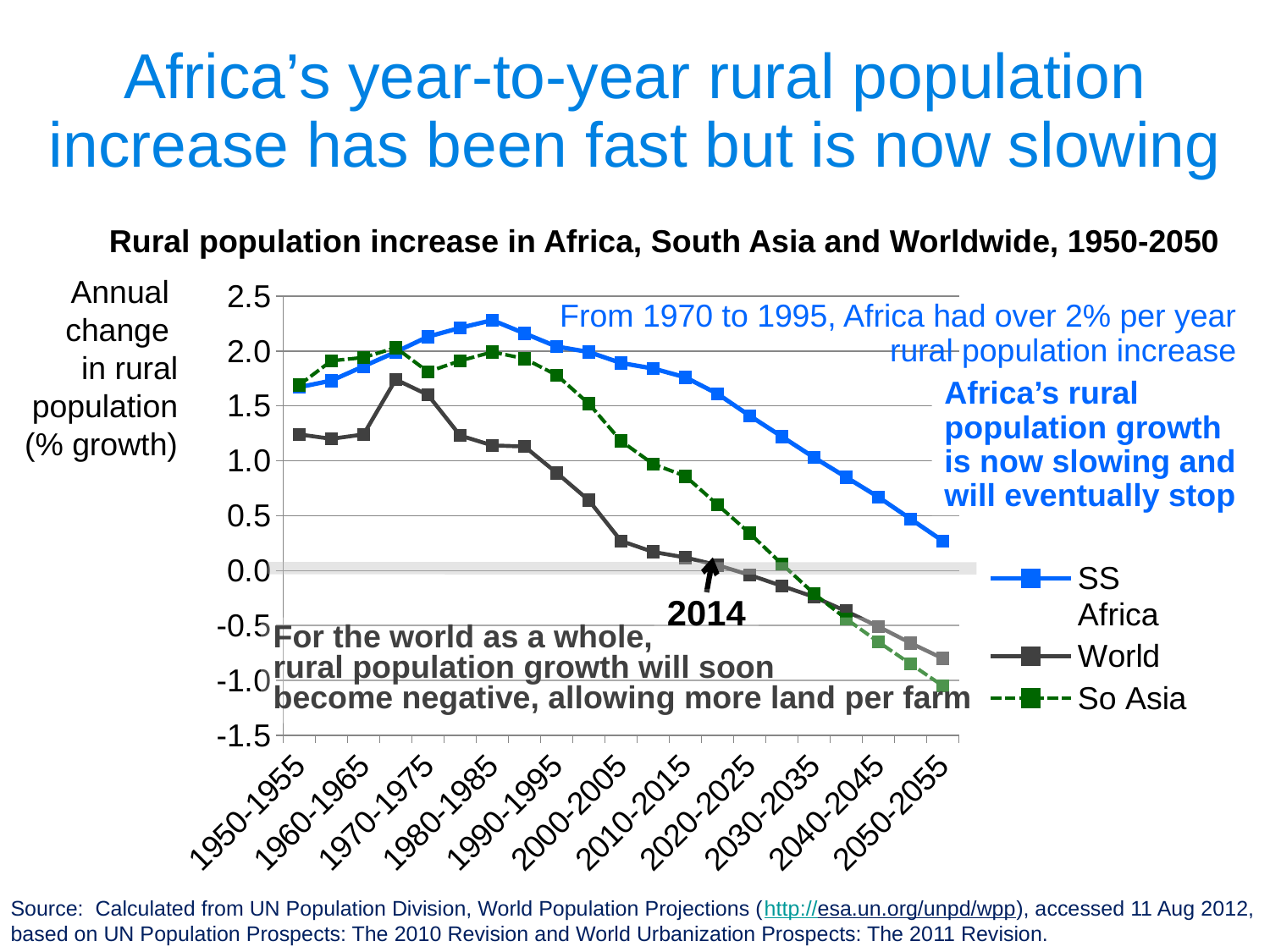
Is the value for World in 2050-2055 greater or less than -0.5? less What is the title of the chart? Rural population increase in Africa, South Asia and Worldwide, 1950-2050 How many period labels are shown on the x axis? 11 Is the value for SS Africa in 1980-1985 greater or less than 2.0? greater Is the value for SS Africa in 2050-2055 greater or less than 0.0? greater How many series does the legend list? 3 Does the SS Africa series rise or fall from 1990-1995 to 2050-2055? fall Which series has the lowest value in 2050-2055? So Asia What are the three series named in the legend? SS Africa, World, So Asia In 2050-2055, which series has the higher value, SS Africa or World? SS Africa What kind of chart is shown on the slide? line chart